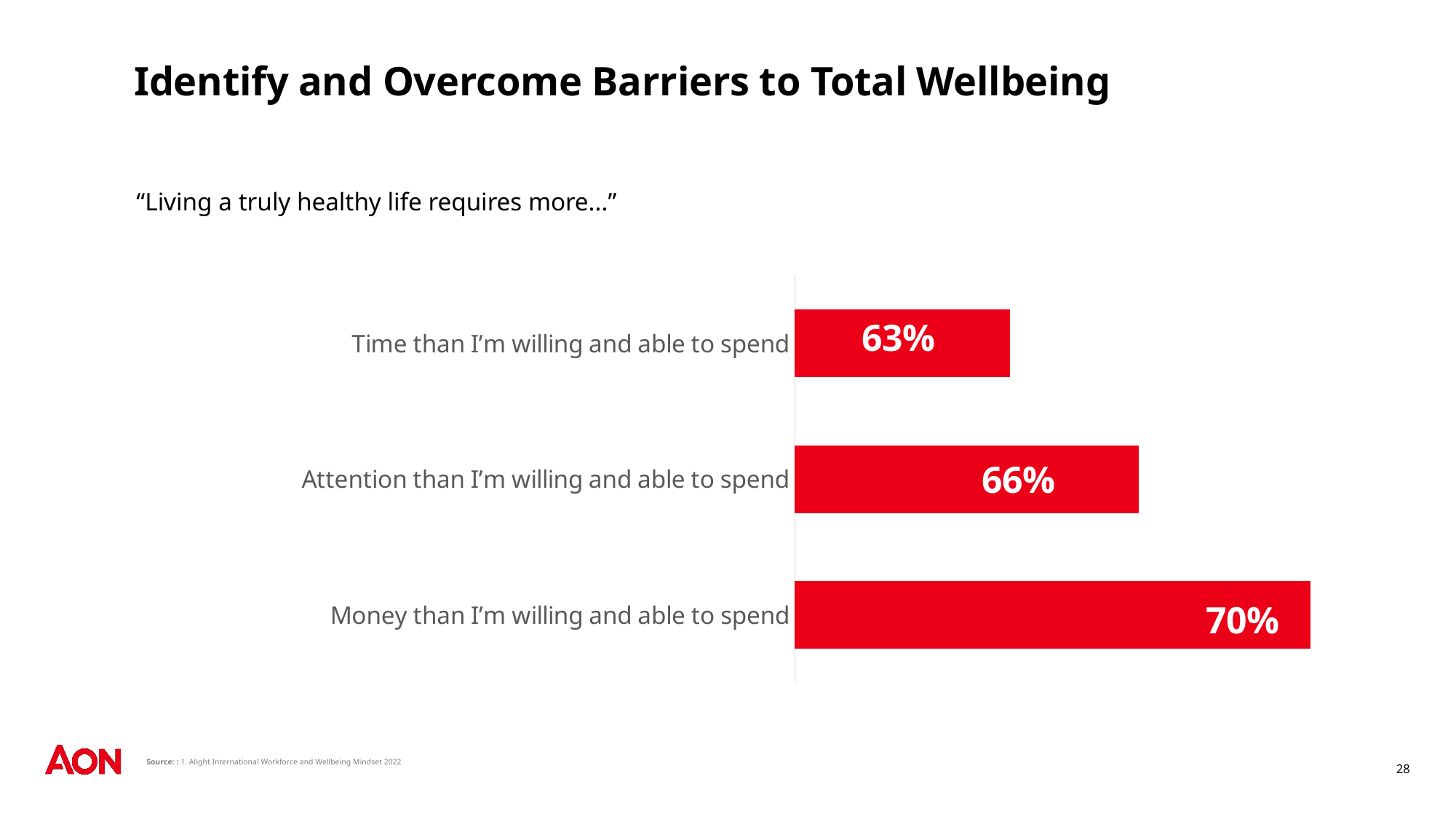
What kind of chart is shown on the slide? Bar chart Which category has the highest value? Money than I'm willing and able to spend What is the difference between the values for Money and Time? 7% Which is larger, the value for Attention or the value for Time? Attention How many categories are shown in the chart? 3 What colour are the bars in the chart? Red What percentage is shown for "Time than I'm willing and able to spend"? 63% What percentage is shown for "Attention than I'm willing and able to spend"? 66% What is the difference between the values for Attention and Time? 3% What percentage is shown for "Money than I'm willing and able to spend"? 70% Which category has the lowest value? Time than I'm willing and able to spend What quote introduces the chart? "Living a truly healthy life requires more..."